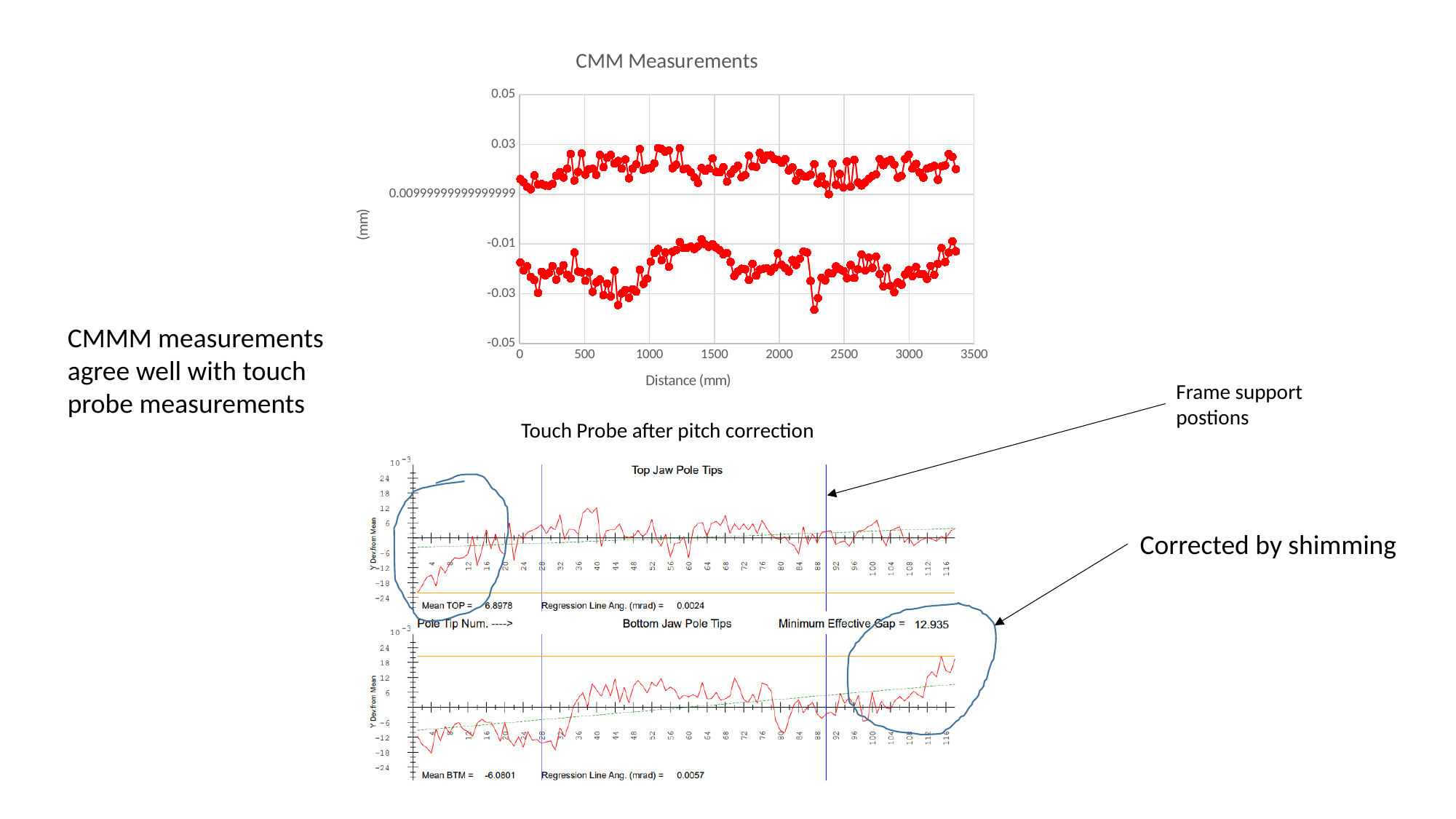
In the CMM Measurements chart, are the values of the upper band of points greater or less than 0.01? greater In the CMM Measurements chart, what is the title of the x axis? Distance (mm) In the Touch Probe after pitch correction chart, what is the Regression Line Ang. (mrad) printed for the Bottom Jaw Pole Tips panel? 0.0057 In the Touch Probe after pitch correction chart, what is the value printed for Mean BTM? -6.0801 In the CMM Measurements chart, what is the largest value labelled on the x axis? 3500 In the CMM Measurements chart, what is the highest value labelled on the y axis? 0.05 In the CMM Measurements chart, are the values of the lower band of points greater or less than -0.05? greater What is the title of the top chart on the slide? CMM Measurements In the Touch Probe after pitch correction chart, what is the value printed for Mean TOP? 6.8978 In the CMM Measurements chart, how many separate bands of data points are plotted? 2 In the Touch Probe after pitch correction chart, what is the printed Minimum Effective Gap? 12.935